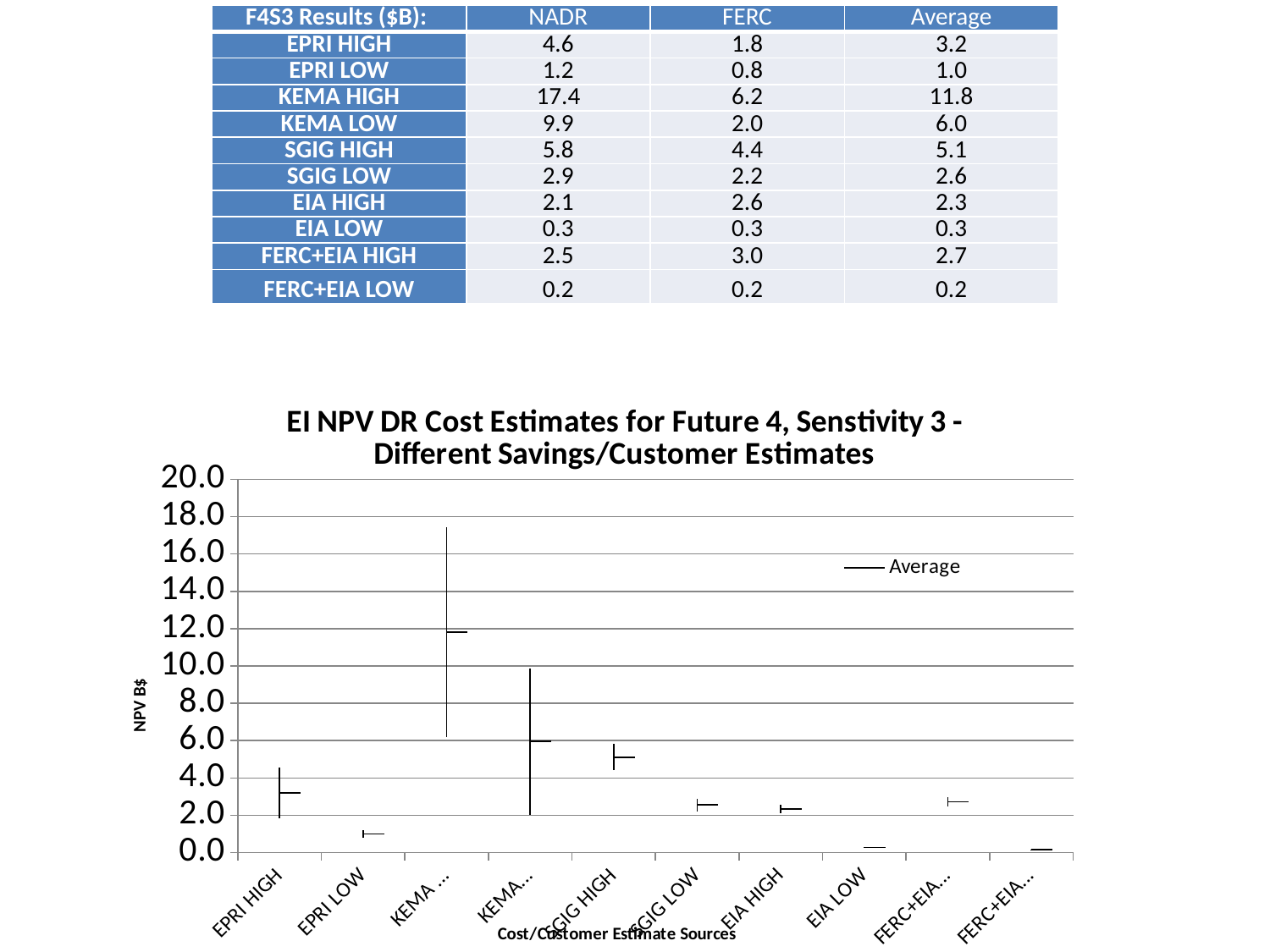
Is the Average value for EPRI HIGH greater or less than 4.0? less Which has the larger Average value, SGIG HIGH or SGIG LOW? SGIG HIGH How many categories are plotted along the x axis of the chart? 10 What is the label of the chart's vertical axis? NPV B$ How many series does the chart legend list? 1 Is the Average value for KEMA LOW greater or less than 8.0? less What is the title of the chart? EI NPV DR Cost Estimates for Future 4, Senstivity 3 - Different Savings/Customer Estimates Is the Average value for KEMA HIGH greater or less than 10.0? greater According to the table above the chart, what is the Average value for KEMA HIGH? 11.8 Which has the larger Average value, KEMA LOW or EPRI HIGH? KEMA LOW Which category has the highest Average value in the chart? KEMA HIGH